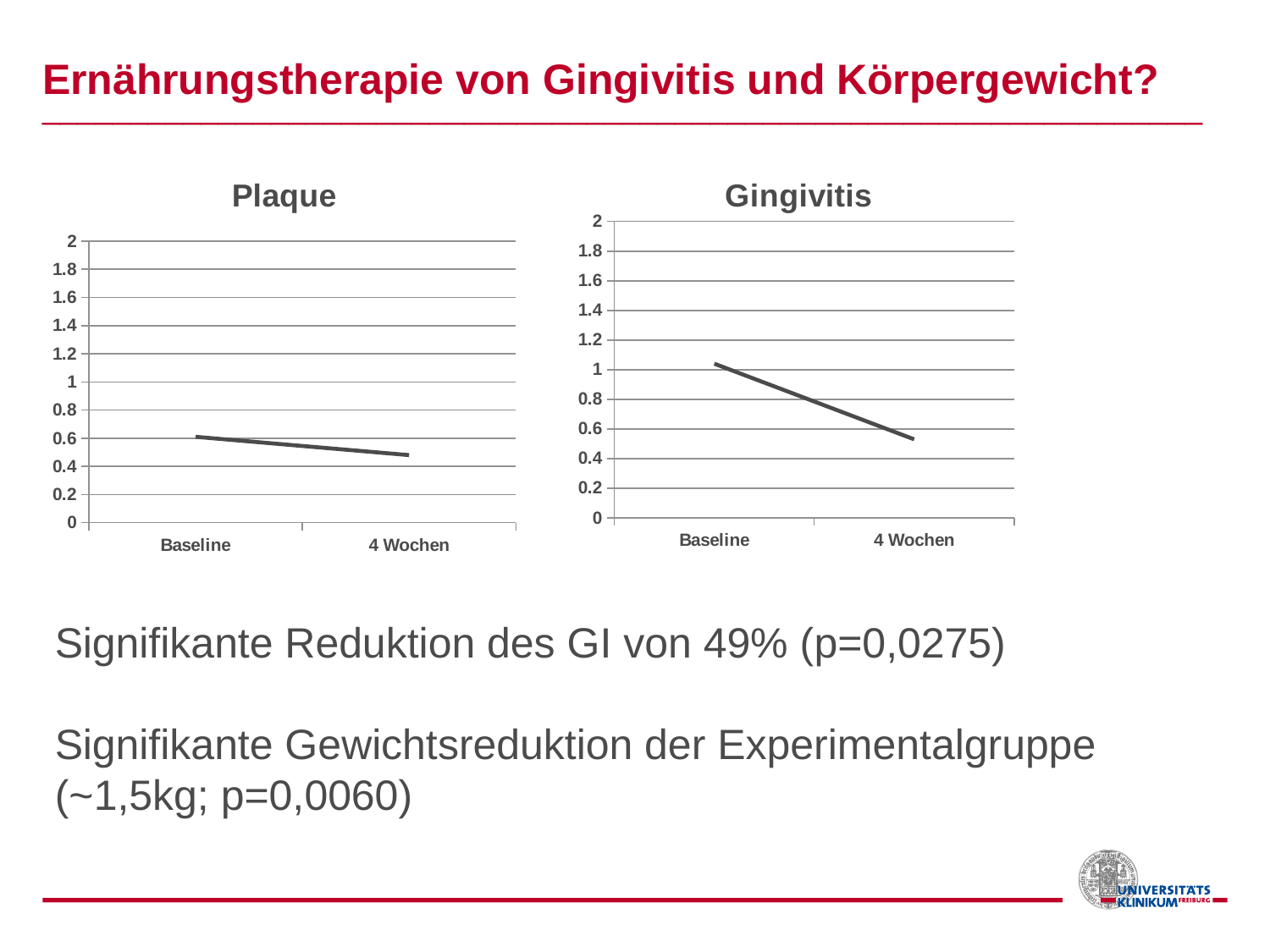
In the Gingivitis chart, do the values rise or fall from Baseline to 4 Wochen? fall What kind of chart is the Plaque chart? line chart In the Plaque chart, is the value at Baseline greater or less than 0.8? less In the Plaque chart, do the values rise or fall from Baseline to 4 Wochen? fall In the Gingivitis chart, is the value at Baseline greater or less than 0.8? greater In the Plaque chart, is the value at 4 Wochen greater or less than 0.6? less In the Gingivitis chart, which time point has the higher value, Baseline or 4 Wochen? Baseline How many data points are plotted in the Gingivitis chart? 2 Which is larger: the Baseline value in the Gingivitis chart or the Baseline value in the Plaque chart? Gingivitis Baseline What are the two categories on the x axis of the Plaque chart? Baseline and 4 Wochen What kind of chart is the Gingivitis chart? line chart